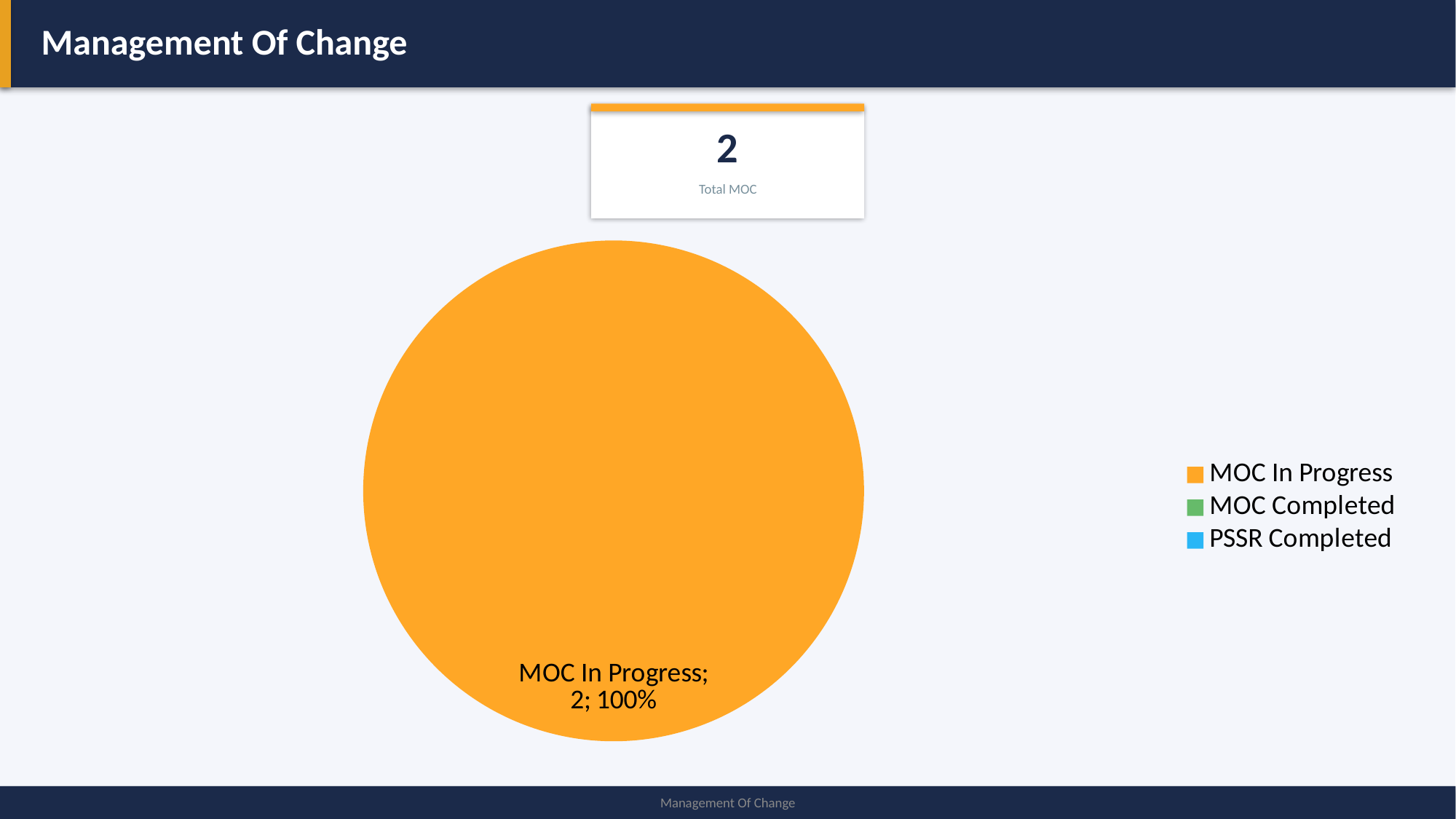
How many slices are visible in the pie chart? 1 What is the Total MOC value shown in the card above the chart? 2 How many entries does the legend list? 3 Which legend entry is shown in green? MOC Completed What colour is the MOC In Progress slice? orange What share of the pie does MOC In Progress represent? 100% What is the value for MOC In Progress in the pie chart? 2 What kind of chart is shown on the slide? pie chart Which category is the largest slice of the pie chart? MOC In Progress